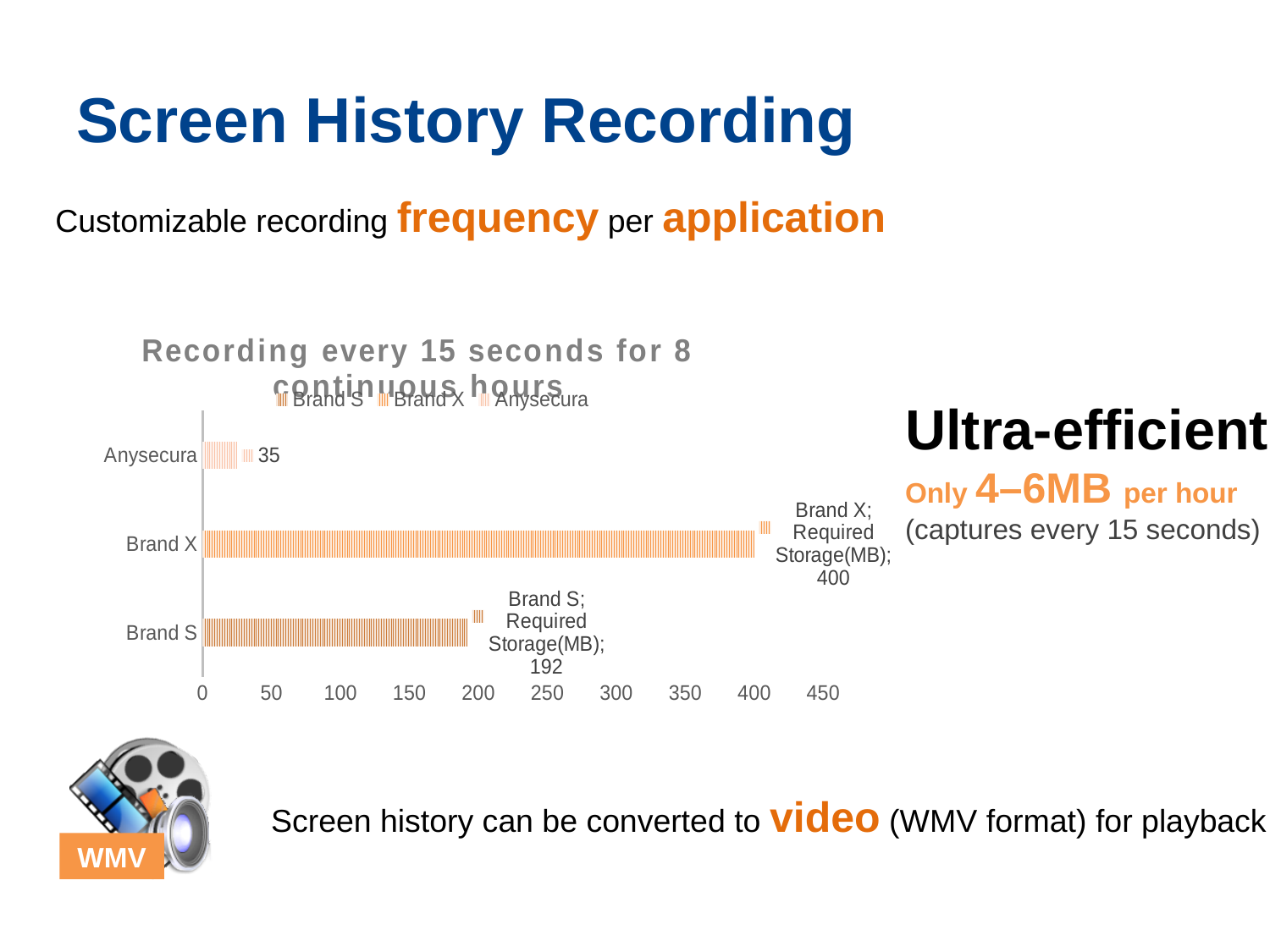
What is the difference between the values for Brand S and Anysecura? 157 Which category has the highest value in the chart? Brand X Which is larger, the value for Brand S or the value for Anysecura? Brand S What is the required storage value shown for Brand X? 400 What is the required storage value shown for Brand S? 192 How many categories are plotted in the chart? 3 Is the value for Brand X greater or less than 350? greater How many entries does the chart legend list? 3 What type of chart is shown on the slide? Bar chart What is the difference between the values for Brand X and Brand S? 208 What value is shown for Anysecura? 35 Which category has the lowest value in the chart? Anysecura